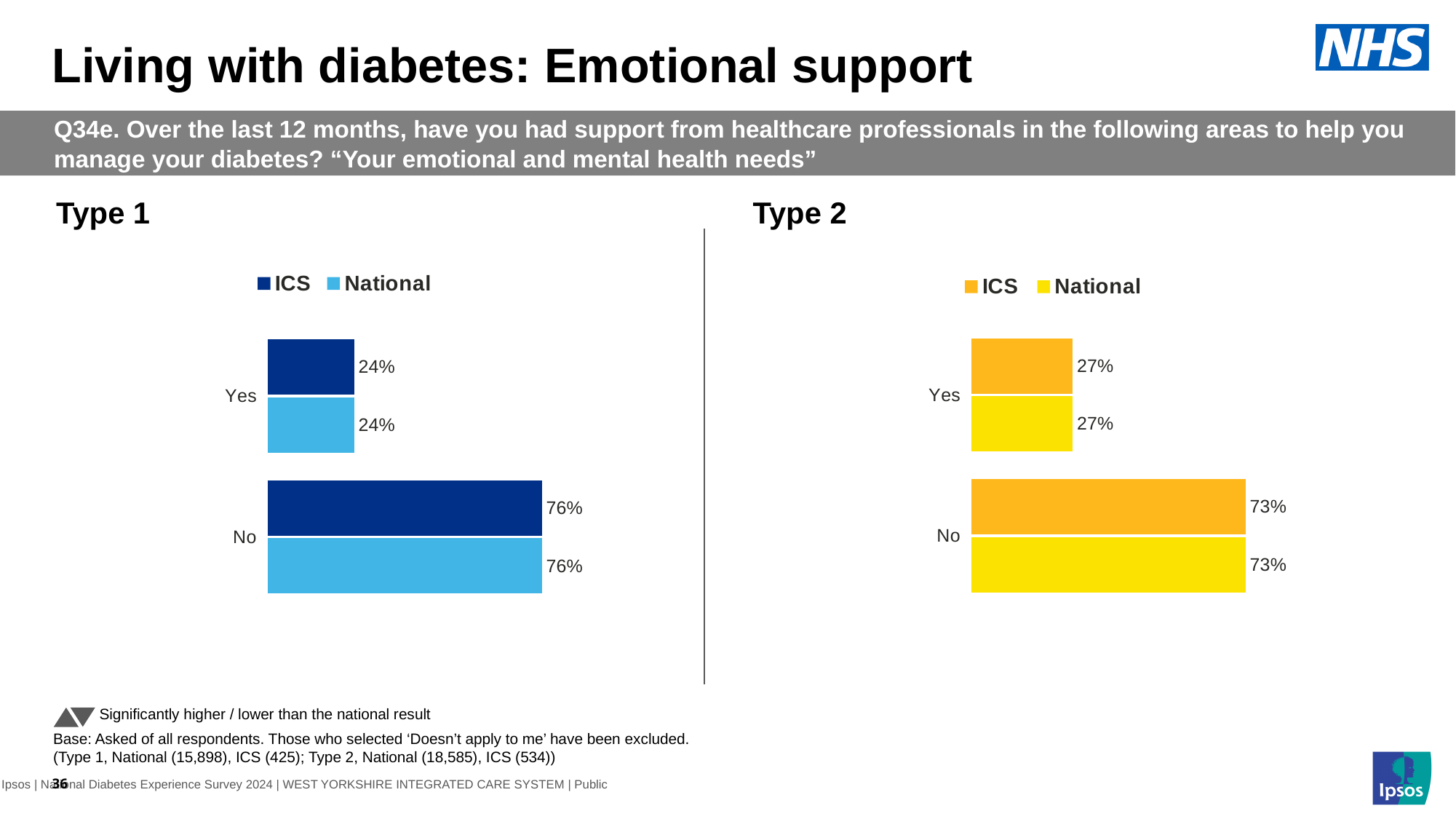
In the Type 2 chart, what is the difference between the National values for No and Yes? 46 percentage points Which is larger: the ICS value for Yes in the Type 1 chart or the ICS value for Yes in the Type 2 chart? Type 2 In the Type 2 chart, what is the ICS value for Yes? 27% How many series does the legend of the Type 2 chart list? 2 What kind of chart is the Type 1 chart? Bar chart In the Type 2 chart, which category has the lowest National value? Yes In the Type 2 chart, what is the National value for No? 73% How many categories are shown in the Type 1 chart? 2 In the Type 1 chart, what is the difference between the ICS values for No and Yes? 52 percentage points In the Type 1 chart, what is the National value for No? 76% In the Type 1 chart, which category has the highest ICS value? No In the Type 1 chart, what is the ICS value for Yes? 24%